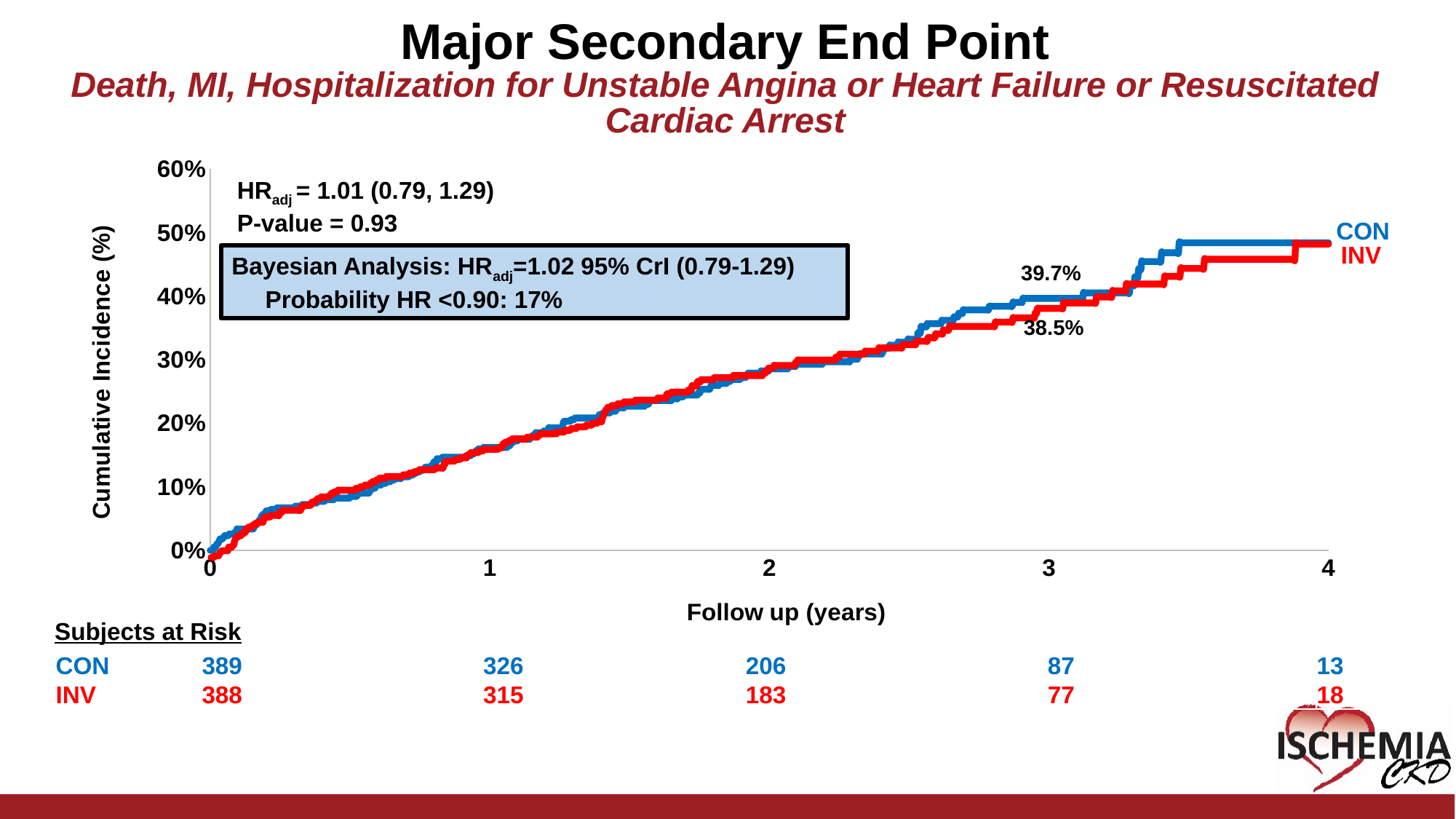
What is the adjusted hazard ratio (HRadj) shown on the chart? 1.01 (0.79, 1.29) What cumulative incidence value is labeled on the chart for the INV group? 38.5% What cumulative incidence value is labeled on the chart for the CON group? 39.7% Which group has the higher labeled cumulative incidence value, CON or INV? CON Do the cumulative incidence curves rise or fall as follow-up time increases? Rise Is the cumulative incidence for the INV group at 1 year of follow up greater or less than 20%? less What is the difference between the labeled cumulative incidence values for CON (39.7%) and INV (38.5%)? 1.2 percentage points How many series (groups) are plotted on the chart? 2 How many subjects at risk are listed for the INV group at year 2? 183 Is the cumulative incidence for the CON group at 4 years of follow up greater or less than 40%? greater What type of chart is shown on the slide? Line chart How many subjects at risk are listed for the CON group at year 0? 389